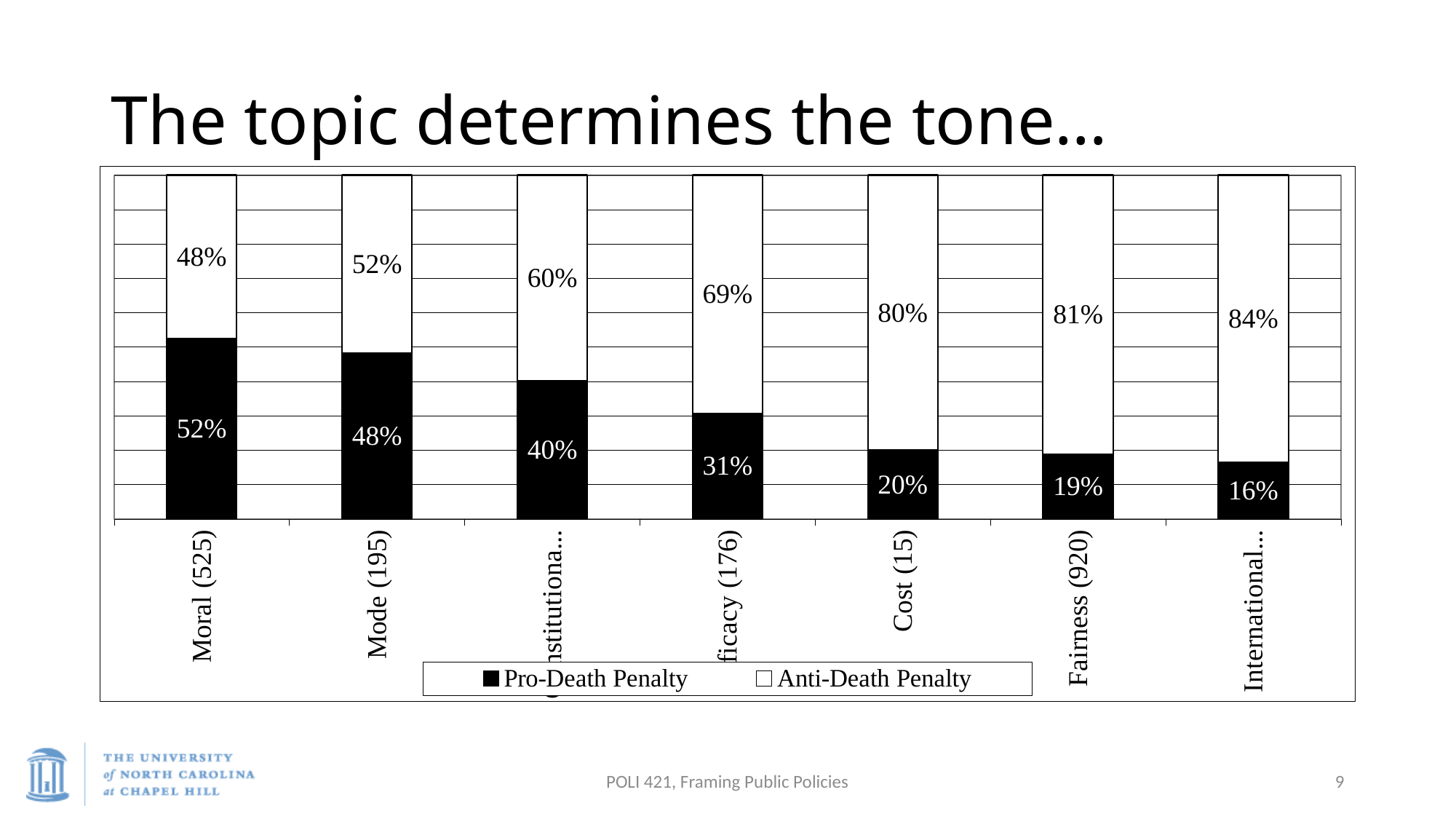
How many series does the legend list? 2 What is the difference between the Anti-Death Penalty and Pro-Death Penalty values for Cost (15)? 60 percentage points Which category has the highest Pro-Death Penalty value? Moral (525) Which category has the lowest Anti-Death Penalty value? Moral (525) What is the Anti-Death Penalty value for Mode (195)? 52% How many categories are shown on the x axis? 7 What is the Anti-Death Penalty value for Fairness (920)? 81% Do the Pro-Death Penalty values rise or fall moving from left to right along the x axis? Fall What is the Pro-Death Penalty value for Moral (525)? 52% Which has the larger Pro-Death Penalty value, Moral (525) or Mode (195)? Moral (525) What kind of chart is shown on the slide? Stacked bar chart What is the Pro-Death Penalty value for Cost (15)? 20%